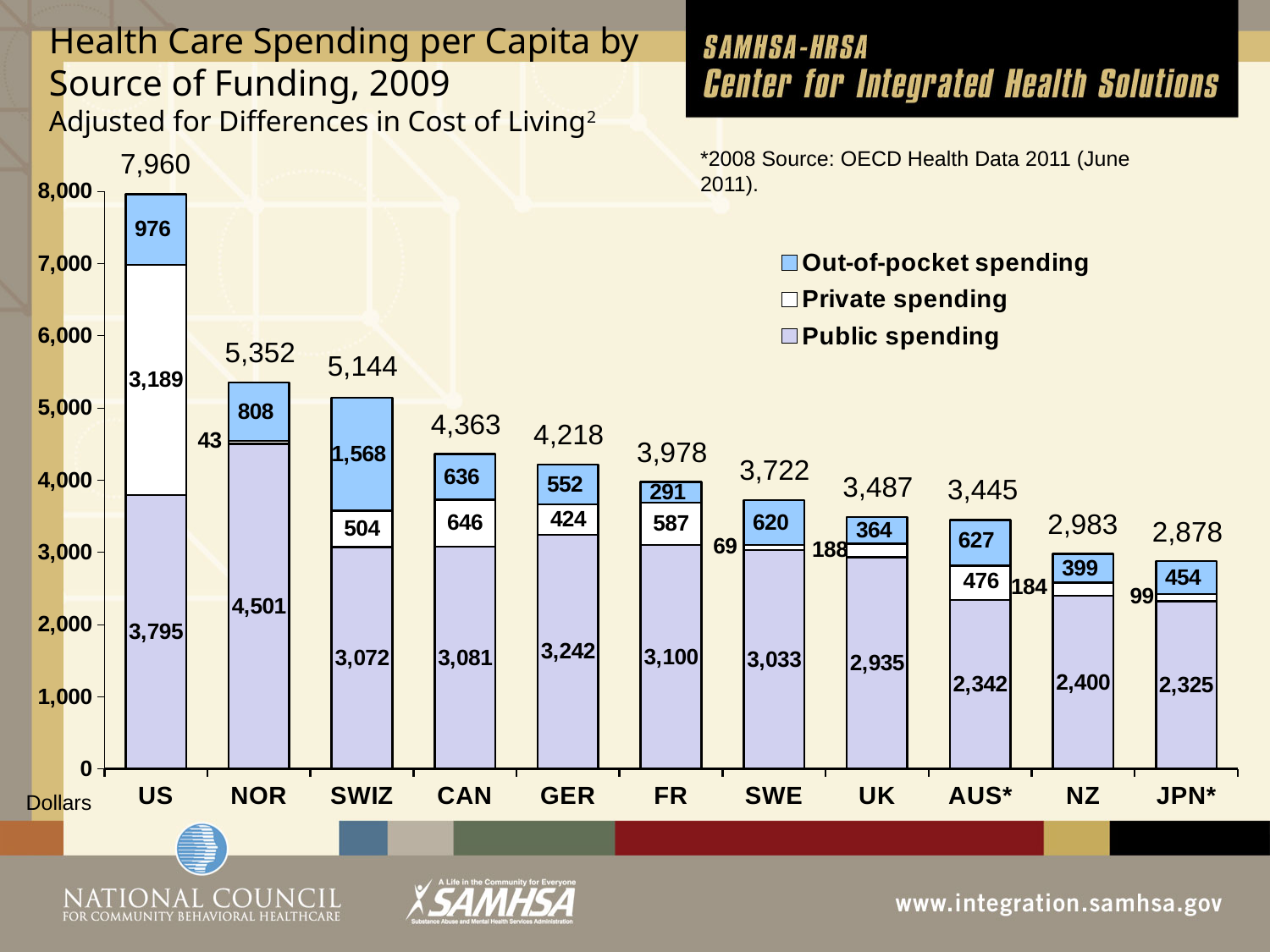
What is the public spending value for Norway (NOR)? 4,501 Do the total spending values rise or fall moving from left to right along the x axis? Fall What kind of chart is shown on the slide? Stacked bar chart Which country has the lowest total health care spending per capita? JPN* How many countries are shown on the x axis? 11 How many series does the legend list? 3 What is the total health care spending per capita shown for the US? 7,960 What is the out-of-pocket spending value for Switzerland (SWIZ)? 1,568 What is the private spending value for Canada (CAN)? 646 What is the difference between the total spending for the US and for Norway (NOR)? 2,608 Which country has the highest total health care spending per capita? US Which is larger, the public spending for Germany (GER) or for France (FR)? Germany (GER)